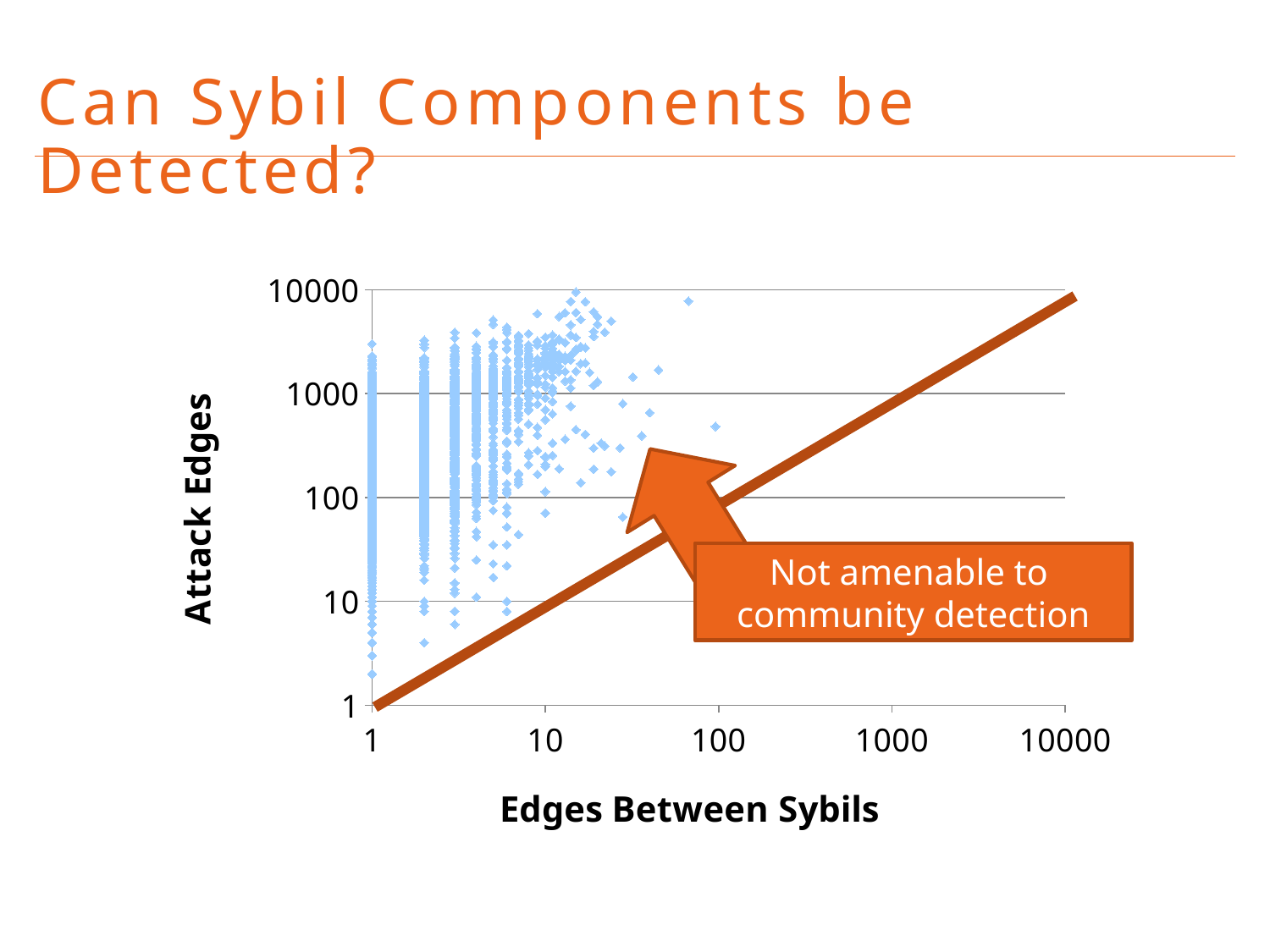
What is the highest tick value shown on the y axis (Attack Edges)? 10000 What is the label of the x axis of the chart? Edges Between Sybils What text is in the orange callout box on the chart? Not amenable to community detection Do most of the plotted points lie above or below the diagonal orange line? above Is the highest Attack Edges value plotted greater or less than 1000? greater What kind of chart is shown on the slide? scatter plot What is the lowest tick value shown on the x axis (Edges Between Sybils)? 1 Is the largest Edges Between Sybils value plotted greater or less than 1000? less